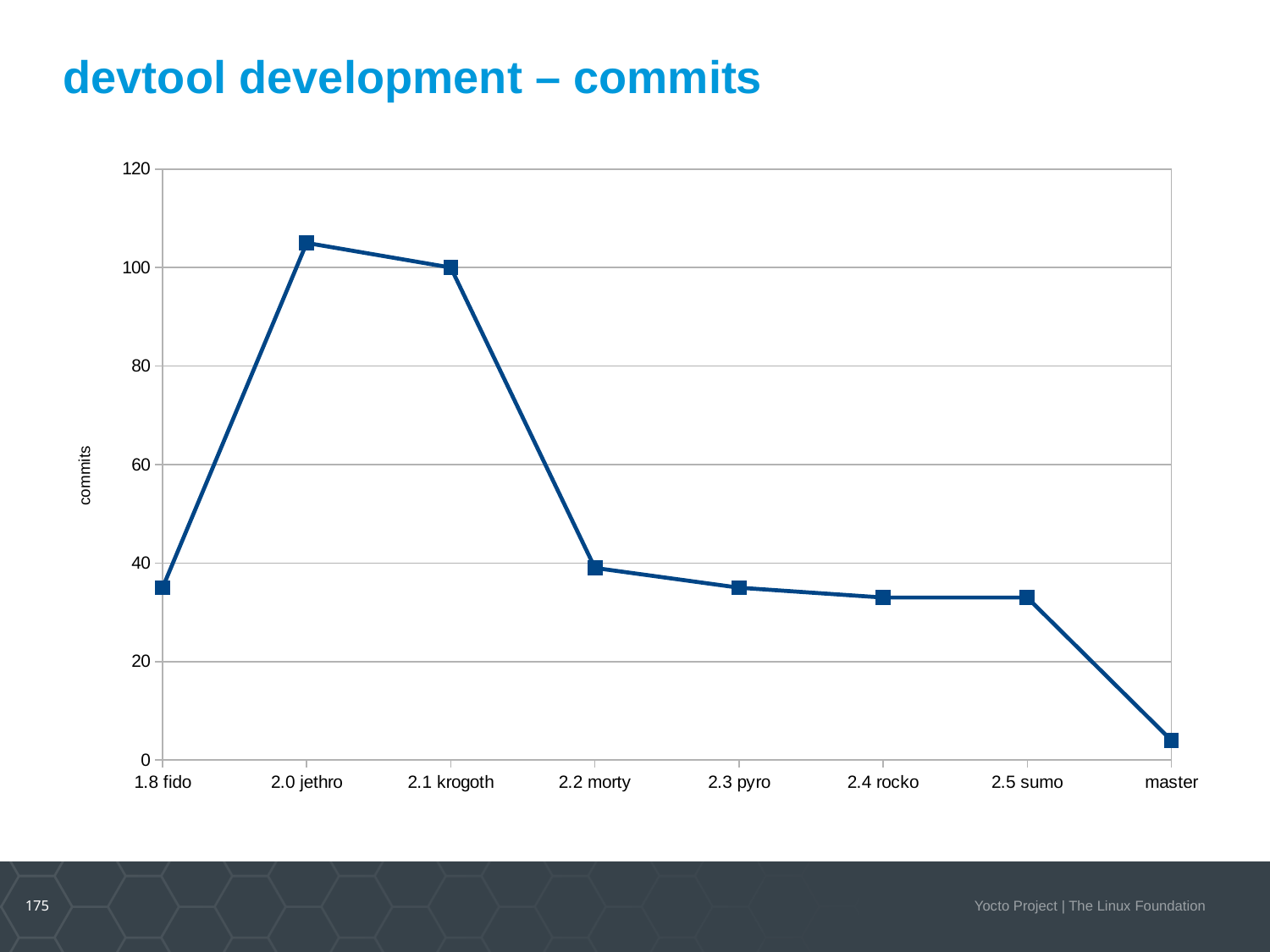
Which release has the lowest number of commits? master Do the commit values rise or fall from 2.1 krogoth to master? fall Is the value for 2.4 rocko greater or less than 40? less Is the value for 1.8 fido greater or less than 40? less What kind of chart is shown on the slide? line chart Which has more commits, 2.1 krogoth or 2.2 morty? 2.1 krogoth Is the value for 2.0 jethro greater or less than 100? greater What is the label on the vertical axis? commits How many releases (points) are plotted along the x axis? 8 Which has more commits, 1.8 fido or master? 1.8 fido Which release has the highest number of commits? 2.0 jethro